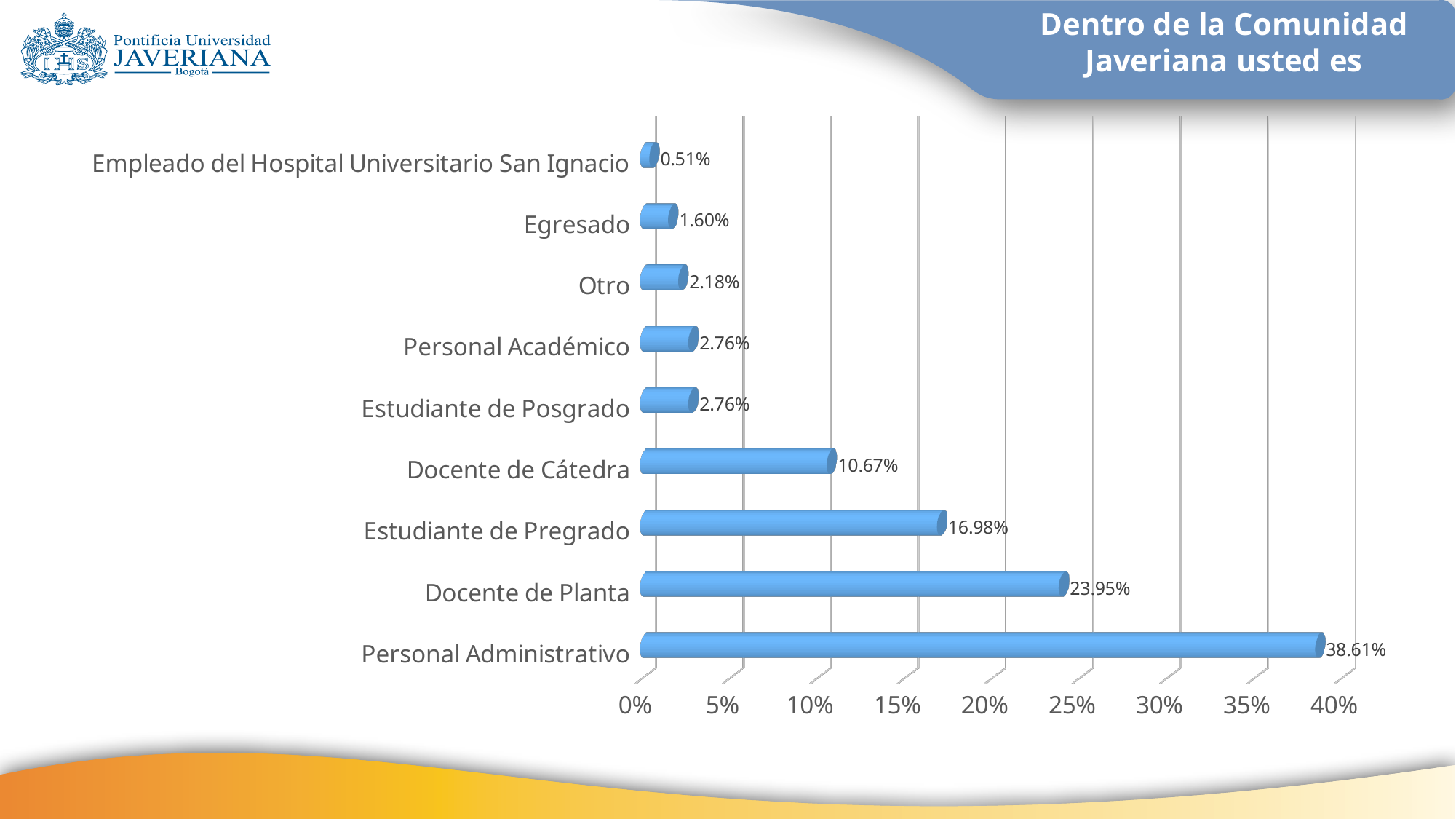
What is the value for Personal Administrativo? 38.61% Is the value for Docente de Planta greater or less than 20%? greater Which category has the highest value? Personal Administrativo What is the difference between the values for Docente de Planta and Estudiante de Pregrado? 6.97% What is the value for Egresado? 1.60% What is the value for Empleado del Hospital Universitario San Ignacio? 0.51% What is the value for Docente de Cátedra? 10.67% What is the title of the slide containing the chart? Dentro de la Comunidad Javeriana usted es Which category has the lowest value? Empleado del Hospital Universitario San Ignacio What kind of chart is shown on the slide? Bar chart How many categories are shown in the chart? 9 Which is larger, the value for Otro or the value for Egresado? Otro